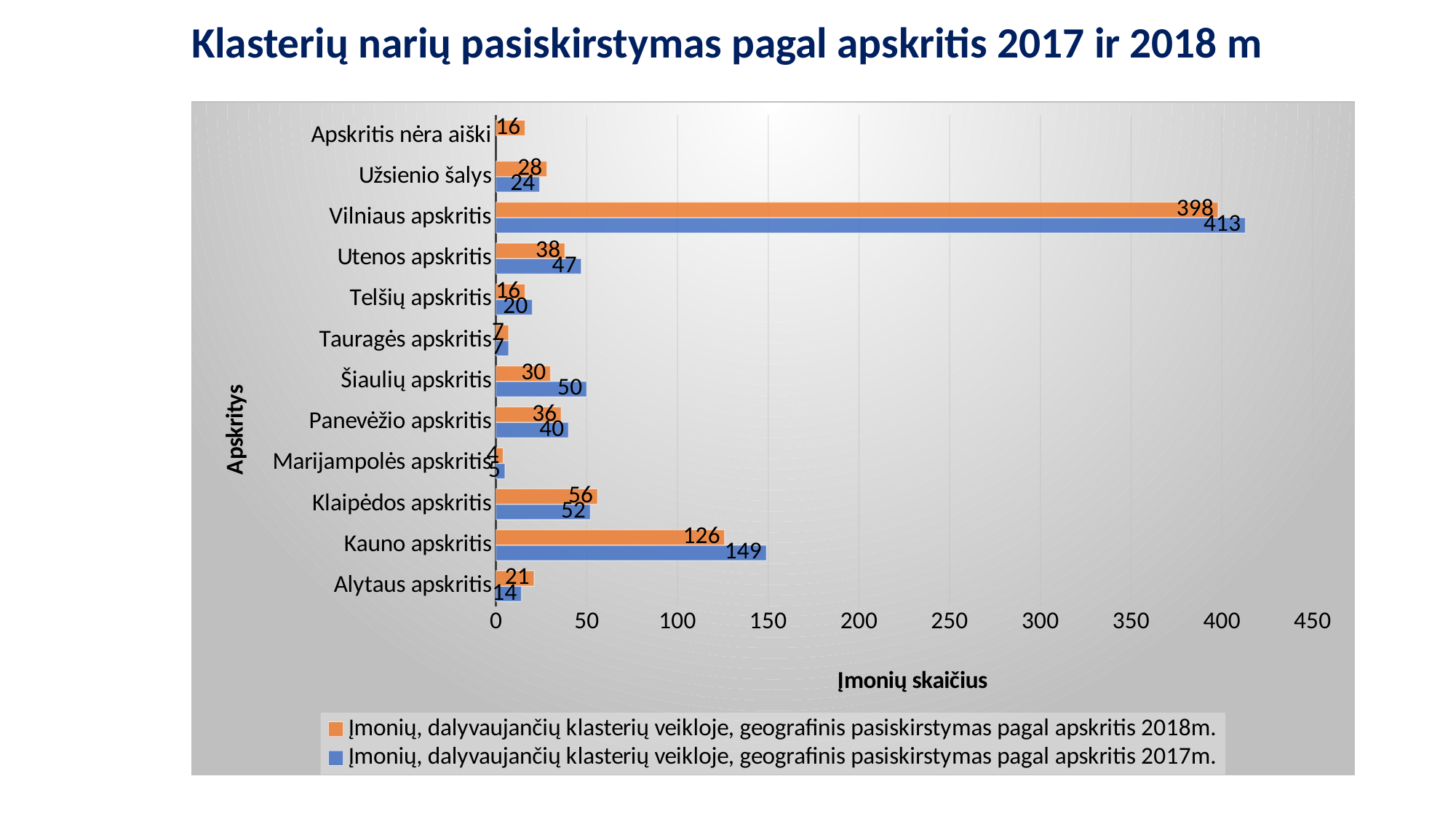
What is the difference between the 2017 and 2018 values for Kauno apskritis? 23 How many categories (apskritys) are shown on the y axis? 12 Which category has the lowest 2018 value? Marijampolės apskritis What type of chart is shown on the slide? bar chart What is the title of the x axis? Įmonių skaičius How many series does the legend list? 2 What is the 2017 value for Šiaulių apskritis? 50 Is the 2017 value for Vilniaus apskritis greater or less than 400? greater What is the 2018 value for Kauno apskritis? 126 Which is larger for Klaipėdos apskritis, the 2018 value or the 2017 value? 2018 value (56) What is the 2017 value for Vilniaus apskritis? 413 Which category has the highest 2018 value? Vilniaus apskritis